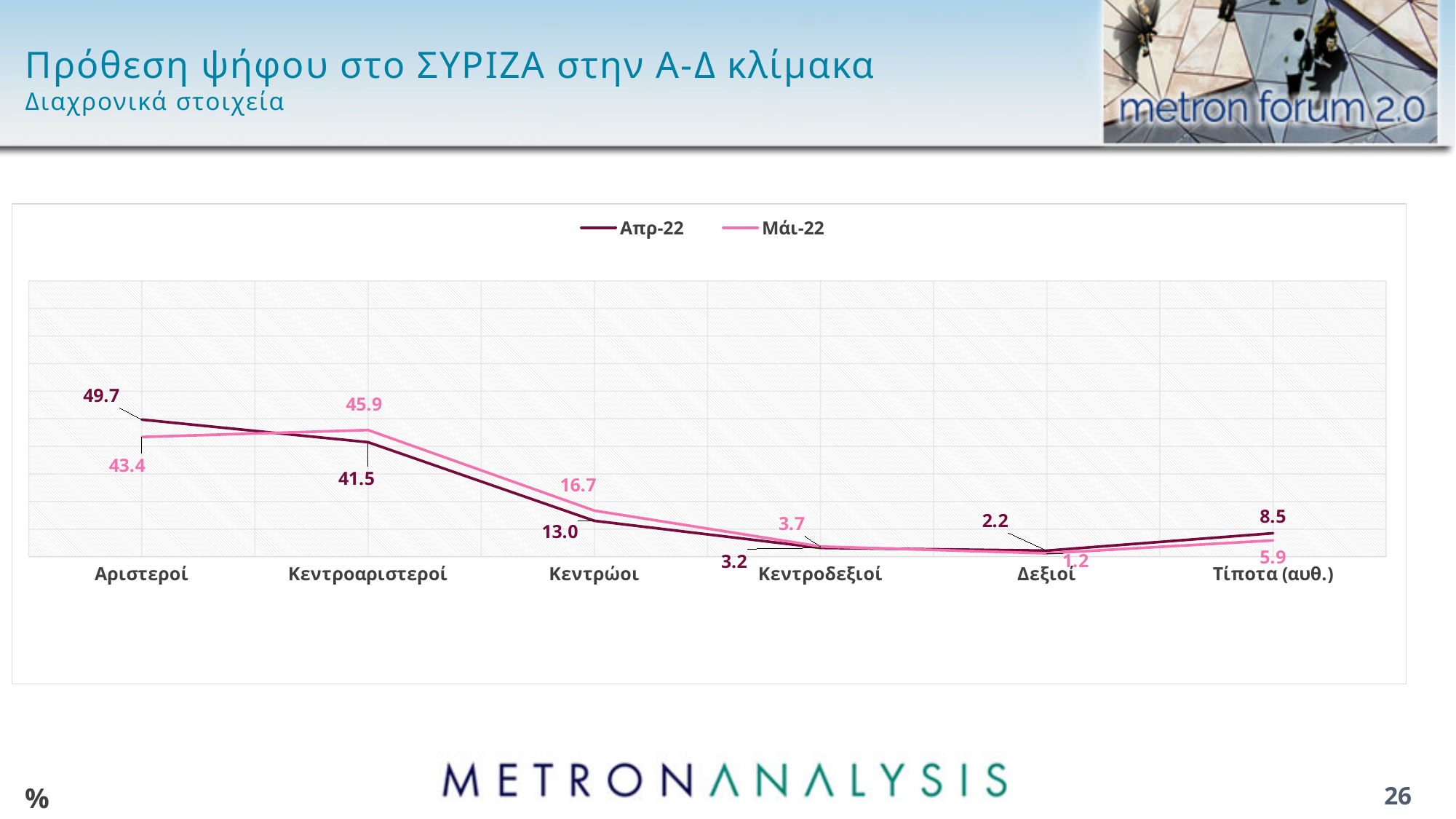
What is the value for Κεντροαριστεροί in the Μάι-22 series? 45.9 What is the value for Κεντρώοι in the Απρ-22 series? 13.0 What is the difference between the Απρ-22 and Μάι-22 values for Αριστεροί? 6.3 What is the value for Αριστεροί in the Απρ-22 series? 49.7 For Κεντρώοι, which series has the larger value, Απρ-22 or Μάι-22? Μάι-22 Which category has the highest value in the Απρ-22 series? Αριστεροί What is the value for Δεξιοί in the Μάι-22 series? 1.2 What kind of chart is shown on the slide? line chart Which series is drawn in pink? Μάι-22 Which category has the lowest value in the Μάι-22 series? Δεξιοί How many categories are shown on the x axis? 6 How many series does the legend list? 2